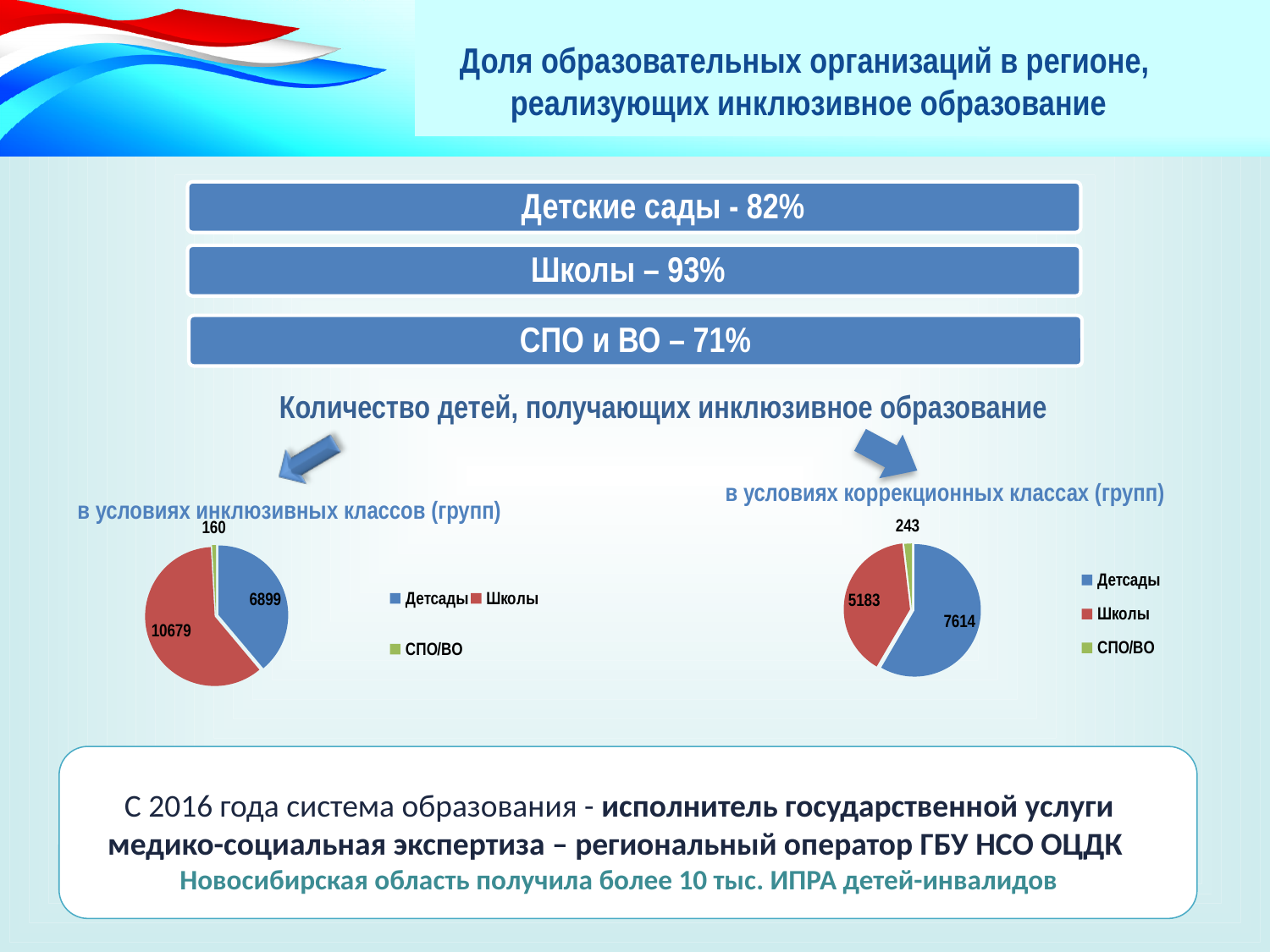
In the left pie chart (в условиях инклюзивных классов (групп)), what is the value for Детсады? 6899 In the left pie chart (в условиях инклюзивных классов (групп)), what is the value for Школы? 10679 In the right pie chart (в условиях коррекционных классах (групп)), which is larger, the value for Детсады or the value for Школы? Детсады How many categories does the left pie chart (в условиях инклюзивных классов (групп)) show? 3 What colour represents Школы in the legend of the left pie chart (в условиях инклюзивных классов (групп))? Red In the right pie chart (в условиях коррекционных классах (групп)), what is the value for СПО/ВО? 243 In the right pie chart (в условиях коррекционных классах (групп)), what is the value for Детсады? 7614 In the left pie chart (в условиях инклюзивных классов (групп)), which category has the largest value? Школы In the right pie chart (в условиях коррекционных классах (групп)), which category has the smallest value? СПО/ВО In the right pie chart (в условиях коррекционных классах (групп)), what is the total of all three values? 13040 In the left pie chart (в условиях инклюзивных классов (групп)), what is the difference between the values for Школы and Детсады? 3780 What type of chart is used for в условиях коррекционных классах (групп)? Pie chart